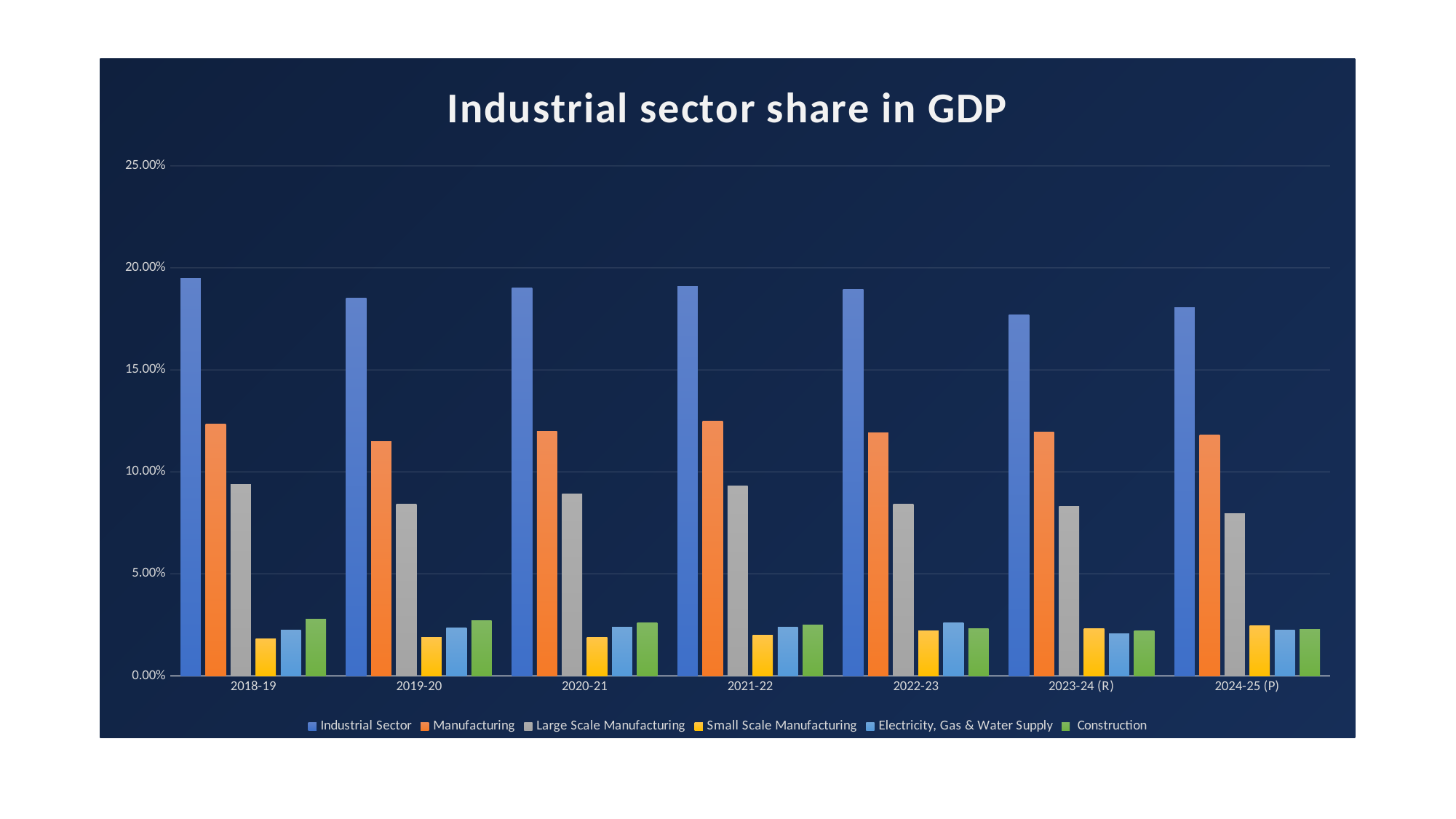
In which year is the Industrial Sector bar the tallest? 2018-19 Is the value for Construction in 2018-19 greater or less than 5.00%? less Is the value for Industrial Sector in 2018-19 greater or less than 15.00%? greater Is the value for Large Scale Manufacturing in 2024-25 (P) greater or less than 10.00%? less How many series does the legend list? 6 Does the Large Scale Manufacturing value rise or fall from 2021-22 to 2024-25 (P)? fall What kind of chart is shown on the slide? bar chart How many fiscal-year categories are shown on the x axis? 7 What is the title of the chart? Industrial sector share in GDP In which year is the Industrial Sector bar the shortest? 2023-24 (R) In 2020-21, which is larger: Manufacturing or Large Scale Manufacturing? Manufacturing